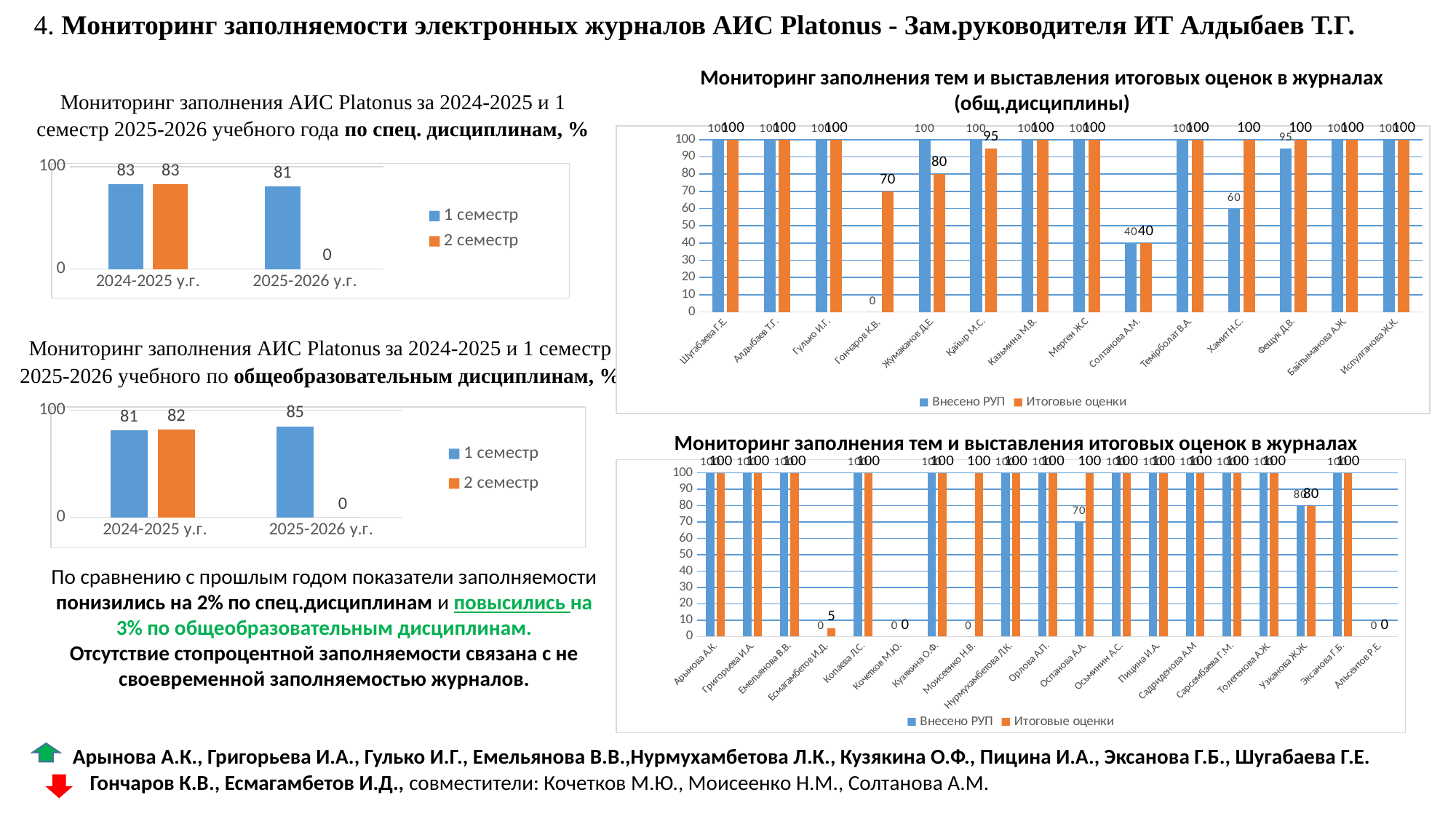
In the bottom-right chart, what is the Итоговые оценки value for Есмагамбетов И.Д.? 5 In the top-right chart (общ.дисциплины), how many teachers are shown on the x axis? 14 In the top-right chart (общ.дисциплины), what is the Итоговые оценки value for Гончаров К.В.? 70 In the top-left chart on special disciplines (по спец. дисциплинам), what is the value for 2 семестр in 2025-2026 у.г.? 0 In the bottom-left chart on general education disciplines, what is the difference between the 1 семестр values for 2025-2026 у.г. and 2024-2025 у.г.? 4 In the bottom-left chart on general education disciplines (по общеобразовательным дисциплинам), what is the value for 1 семестр in 2025-2026 у.г.? 85 In the top-right chart (общ.дисциплины), which teacher has the lowest Итоговые оценки value? Солтанова А.М. What kind of chart is the top-left chart on special disciplines? Bar chart In the bottom-right chart, which is larger for Оспанова А.А.: Внесено РУП or Итоговые оценки? Итоговые оценки In the top-left chart on special disciplines (по спец. дисциплинам), what is the value for 1 семестр in 2024-2025 у.г.? 83 In the top-right chart (общ.дисциплины), what is the Внесено РУП value for Хамит Н.С.? 60 In the bottom-left chart on general education disciplines, how many series does the legend list? 2